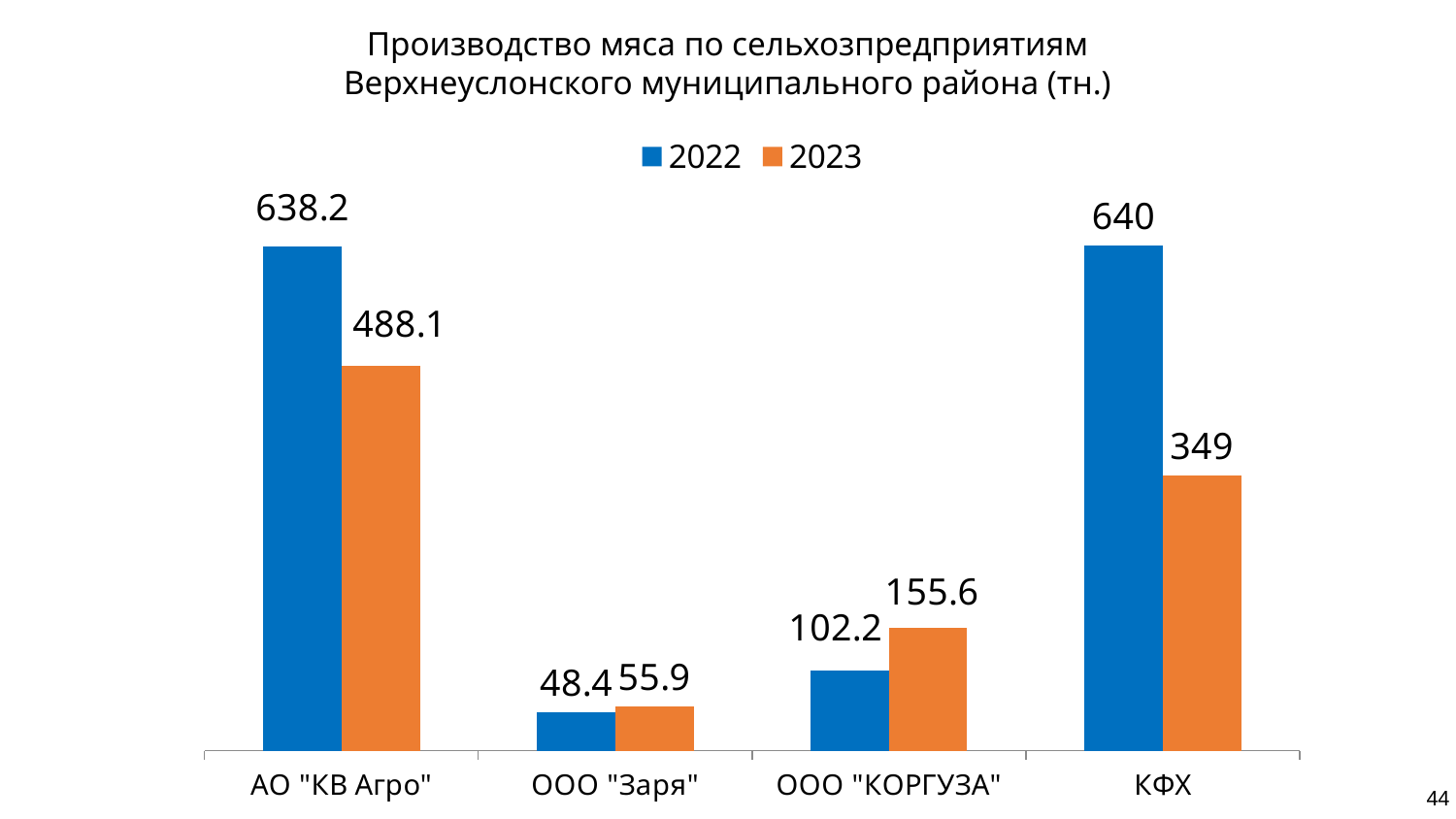
How many series does the legend list? 2 Which enterprise had the highest meat production in 2023? АО "КВ Агро" By how much did meat production at КФХ fall from 2022 to 2023? 291 For ООО "Заря", which year had the larger meat production, 2022 or 2023? 2023 How many enterprises are shown on the x axis? 4 What type of chart is shown on the slide? Bar chart What was the meat production for ООО "Заря" in 2022? 48.4 What was the meat production for АО "КВ Агро" in 2022? 638.2 Which enterprise had the lowest meat production in 2022? ООО "Заря" What was the meat production for ООО "КОРГУЗА" in 2023? 155.6 What was the meat production for КФХ in 2023? 349 What is the difference between the 2023 and 2022 values for ООО "КОРГУЗА"? 53.4